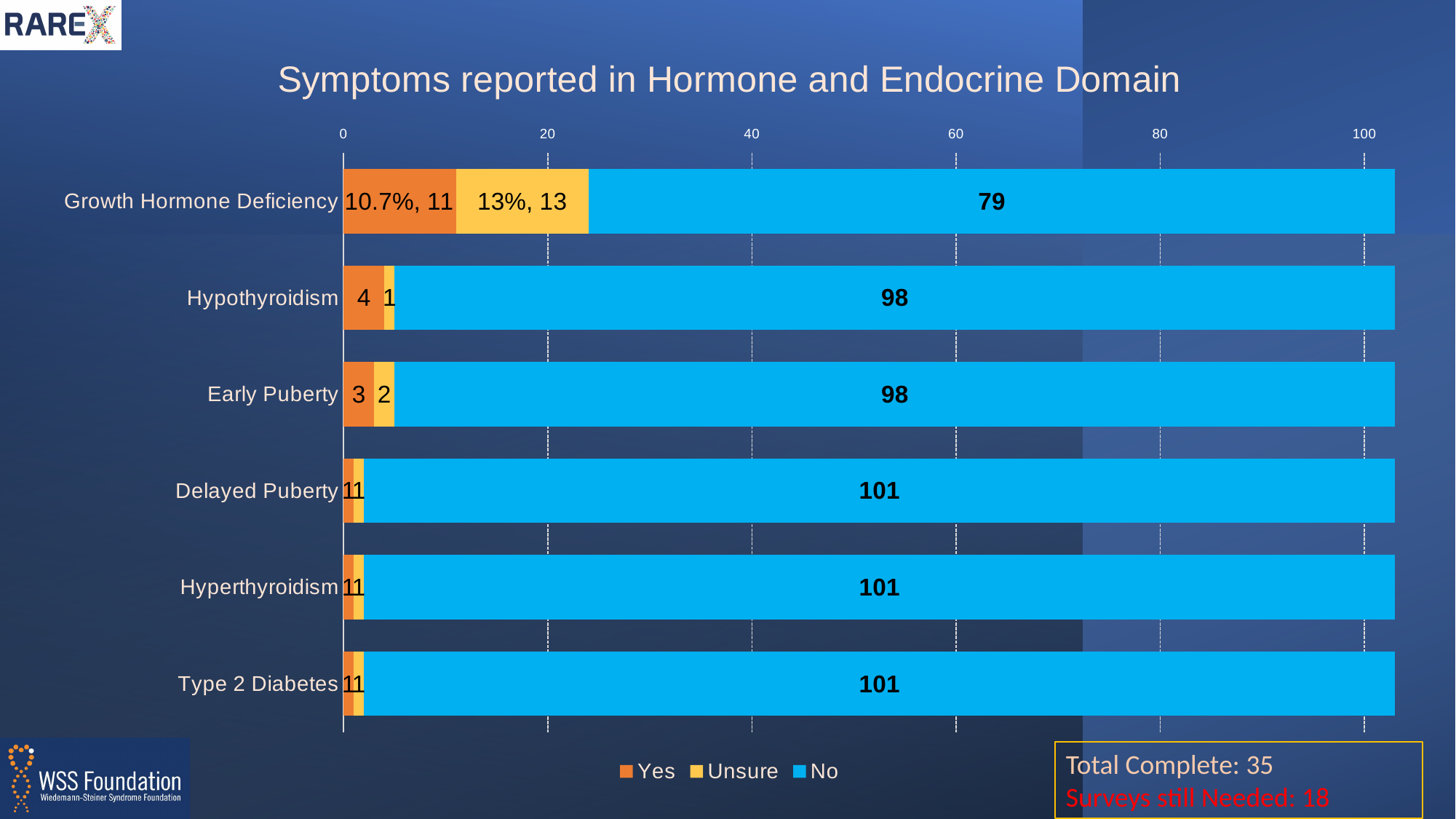
What is the 'Yes' value for Hypothyroidism? 4 How many symptom categories are plotted in the chart? 6 What is the 'No' value for Growth Hormone Deficiency? 79 What is the 'Unsure' value for Early Puberty? 2 Which has a larger 'Yes' value, Hypothyroidism or Early Puberty? Hypothyroidism What is the difference between the 'No' value for Hypothyroidism and the 'No' value for Growth Hormone Deficiency? 19 What percentage is shown for the 'Unsure' segment of Growth Hormone Deficiency? 13% How many series does the legend list? 3 Which category has the lowest 'No' value? Growth Hormone Deficiency What kind of chart is shown on the slide? bar chart Which category has the highest 'Yes' value? Growth Hormone Deficiency What is the total of the stacked bar for Growth Hormone Deficiency (Yes + Unsure + No)? 103